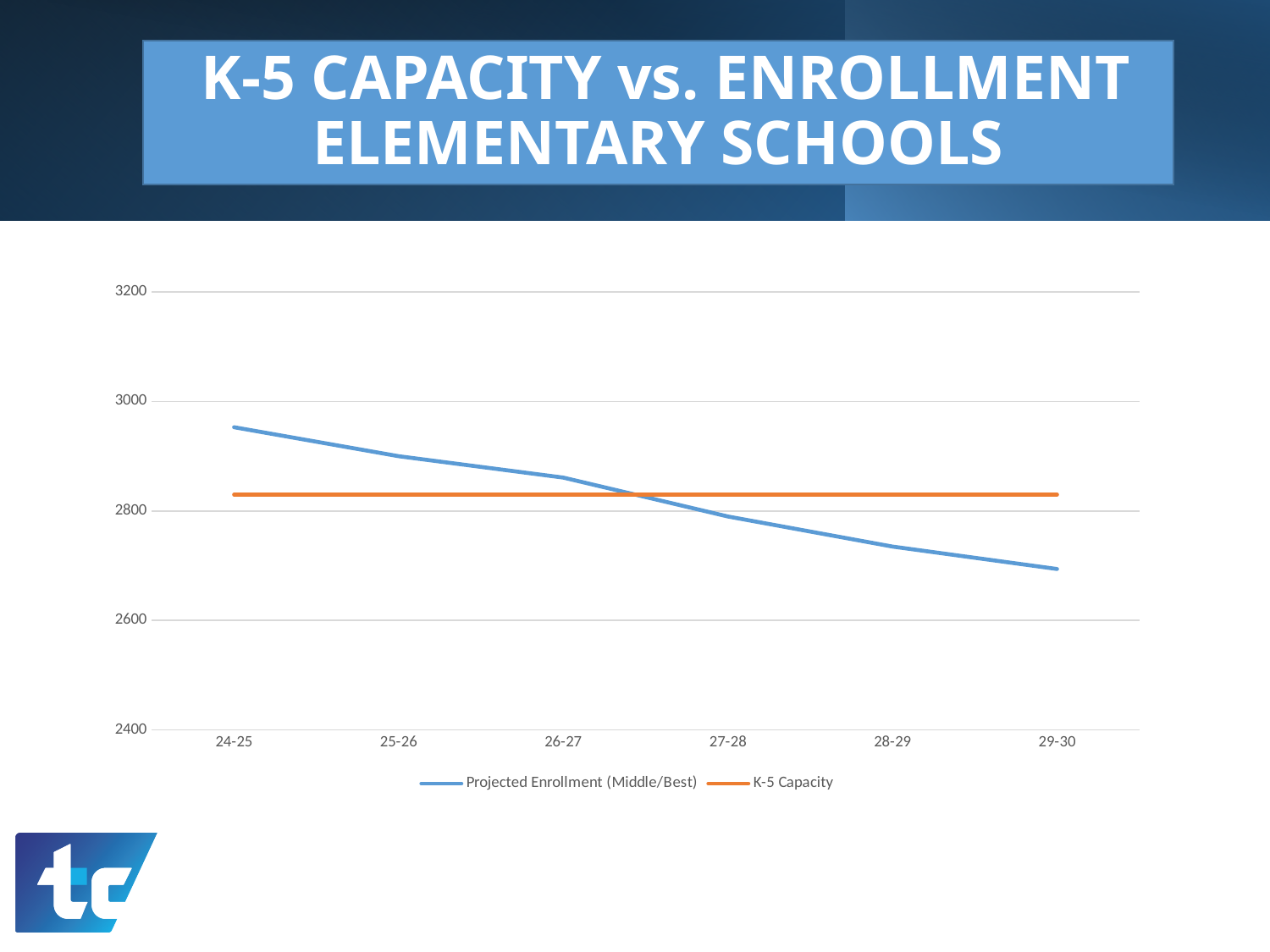
How many series does the legend list? 2 Does the Projected Enrollment (Middle/Best) line rise or fall from 24-25 to 29-30? fall Is the Projected Enrollment (Middle/Best) value for 29-30 greater or less than 2600? greater In 24-25, which is larger: Projected Enrollment (Middle/Best) or K-5 Capacity? Projected Enrollment (Middle/Best) Is the Projected Enrollment (Middle/Best) value for 24-25 greater or less than 2800? greater What kind of chart is shown on the slide? line chart Is the Projected Enrollment (Middle/Best) value for 29-30 greater or less than 2800? less In which school year is Projected Enrollment (Middle/Best) highest? 24-25 In which school year is Projected Enrollment (Middle/Best) lowest? 29-30 How many school years are plotted along the x axis? 6 In 29-30, which is larger: Projected Enrollment (Middle/Best) or K-5 Capacity? K-5 Capacity